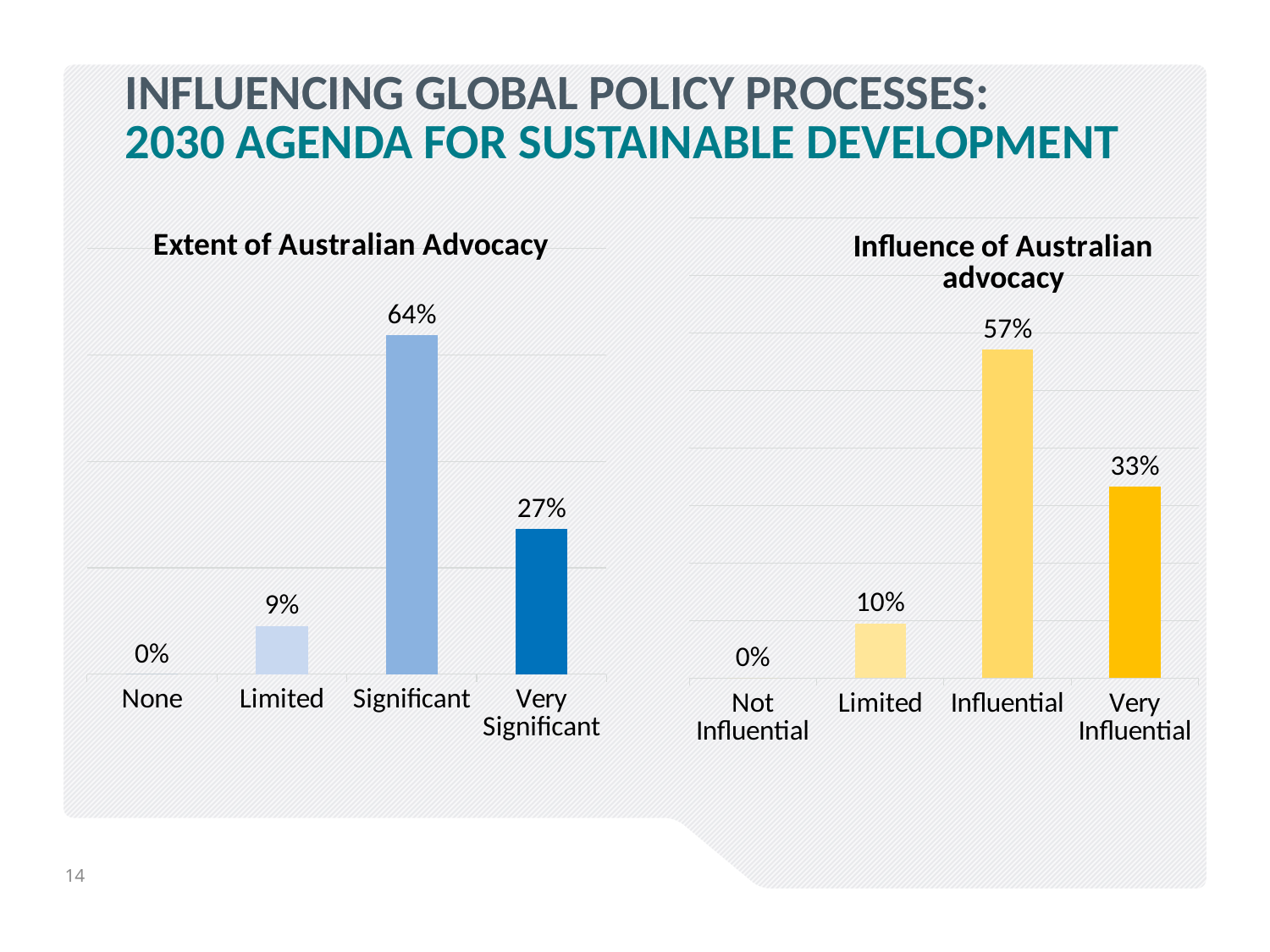
What is the title of the chart on the left side of the slide? Extent of Australian Advocacy In the 'Extent of Australian Advocacy' chart, what is the value for Significant? 64% In the 'Influence of Australian advocacy' chart, what is the value for Very Influential? 33% In the 'Influence of Australian advocacy' chart, what is the difference between Influential and Limited? 47% In the 'Influence of Australian advocacy' chart, which is larger: Influential or Very Influential? Influential How many categories are shown in the 'Extent of Australian Advocacy' chart? 4 In the 'Extent of Australian Advocacy' chart, what is the value for Limited? 9% In the 'Influence of Australian advocacy' chart, which category has the lowest value? Not Influential In the 'Extent of Australian Advocacy' chart, which category has the highest value? Significant What type of chart is the 'Influence of Australian advocacy' chart? Bar chart In the 'Influence of Australian advocacy' chart, what is the value for Not Influential? 0% In the 'Extent of Australian Advocacy' chart, what is the difference between Significant and Very Significant? 37%